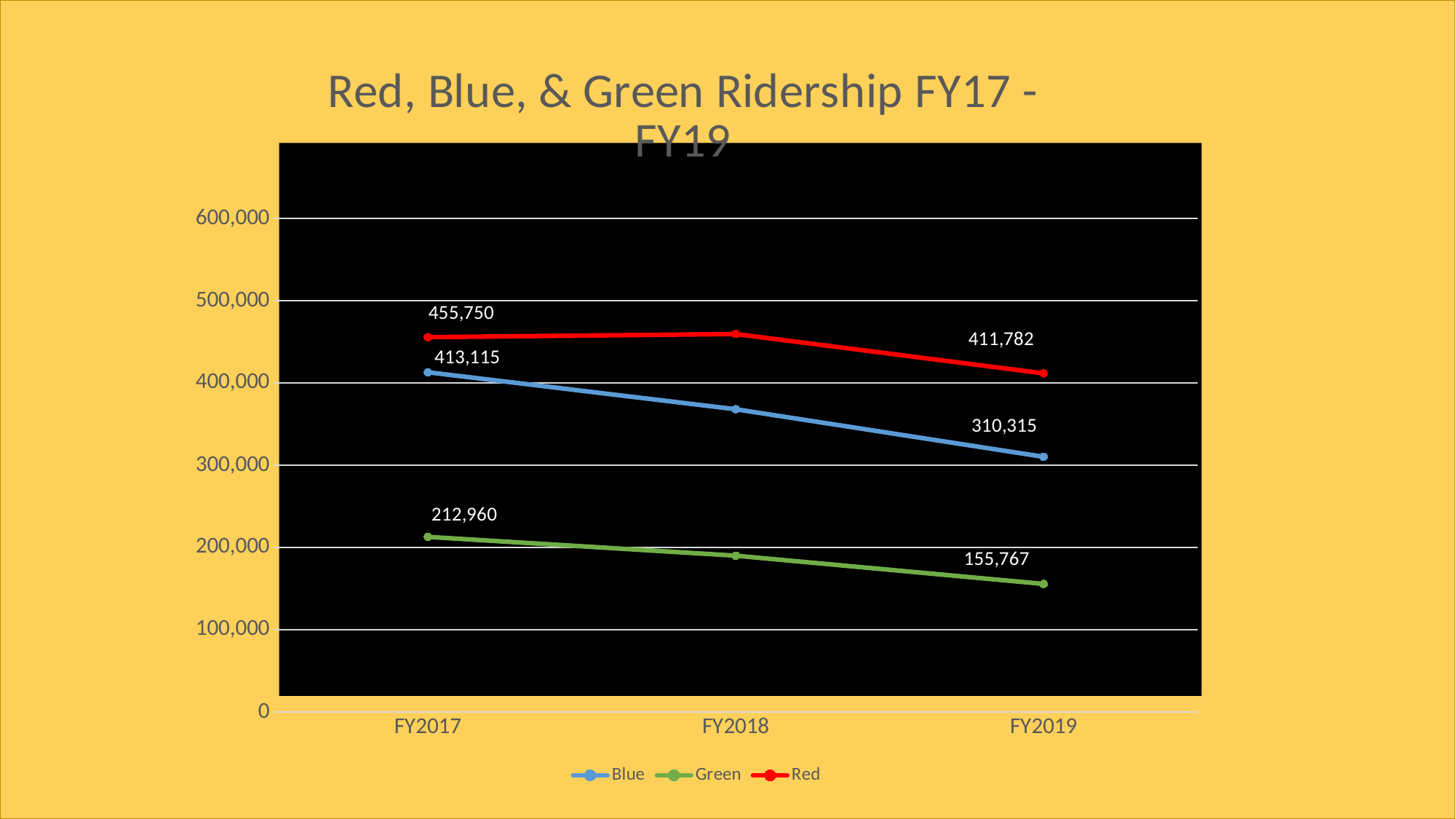
What is the Green ridership value for FY2017? 212,960 What is the Red ridership value for FY2017? 455,750 Is the Blue ridership value for FY2018 greater or less than 400,000? less Which is larger, the Green ridership in FY2017 or the Green ridership in FY2019? FY2017 Which series has the highest ridership in FY2019? Red How many series does the legend list? 3 What is the Blue ridership value for FY2019? 310,315 What kind of chart is shown on the slide? line chart What is the difference between the Blue ridership in FY2017 and FY2019? 102,800 Which series has the lowest ridership in FY2017? Green What is the Red ridership value for FY2019? 411,782 Does the Green ridership rise or fall from FY2017 to FY2019? fall